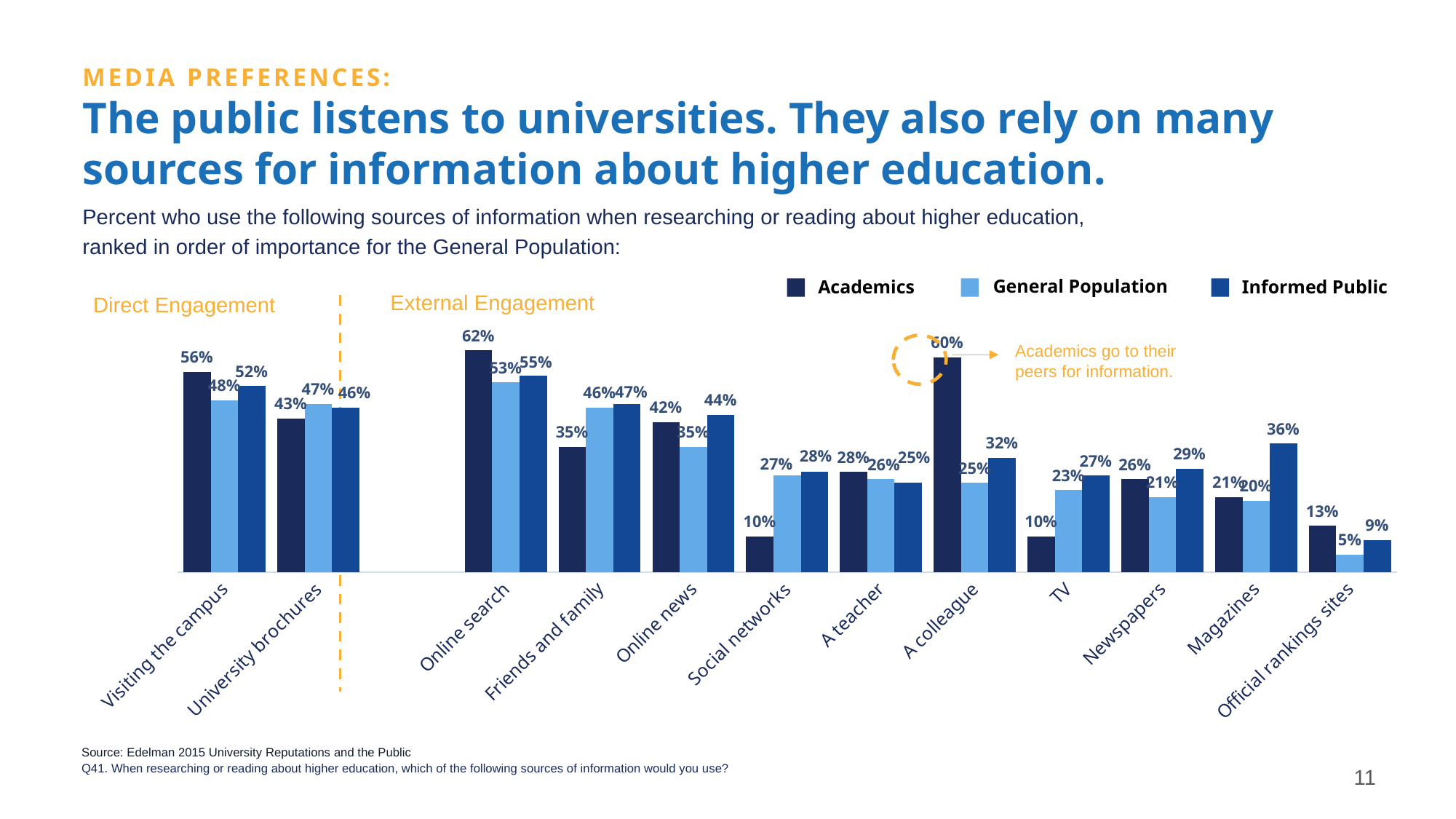
Which source has the highest General Population value? Online search For Visiting the campus, which is larger: the Academics value or the Informed Public value? Academics How many series does the legend list? 3 How many information sources are shown on the x axis? 12 Which source has the lowest Informed Public value? Official rankings sites Which series is shown in the lightest blue in the legend? General Population What kind of chart is shown on the slide? Bar chart What is the difference between the General Population and Academics values for Social networks? 17 percentage points What is the Informed Public value for Magazines? 36% What is the General Population value for Social networks? 27% What is the General Population value for Official rankings sites? 5% What is the Academics value for Online search? 62%